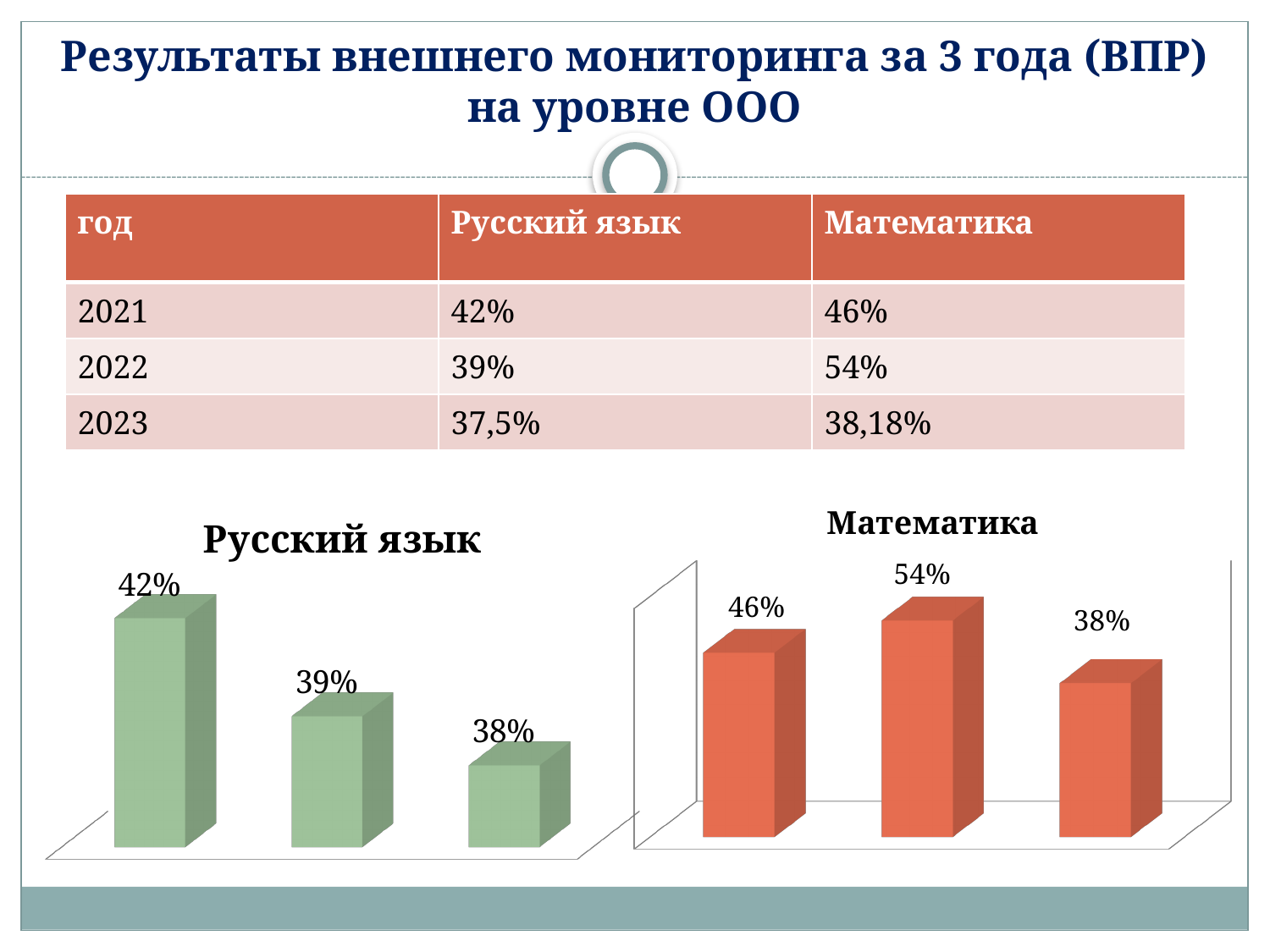
In the "Математика" chart, what value is labelled on the third (rightmost) bar? 38% What colour are the bars in the "Русский язык" chart? green Which is larger: the first bar in the "Русский язык" chart or the first bar in the "Математика" chart? the first bar in the "Математика" chart In the "Русский язык" chart, what is the difference between the first bar's value and the second bar's value? 3% In the "Математика" chart, what is the difference between the middle bar's value and the rightmost bar's value? 16% In the "Русский язык" chart, do the values rise or fall from left to right? fall In the "Русский язык" chart, which bar is the tallest: the first, second or third? the first What type of chart is the "Математика" chart? bar chart How many bars does the "Русский язык" chart have? 3 In the "Математика" chart, what value is labelled on the middle bar? 54% In the "Математика" chart, which bar is the lowest: the first, second or third? the third In the "Русский язык" chart, what value is labelled on the first (leftmost) bar? 42%